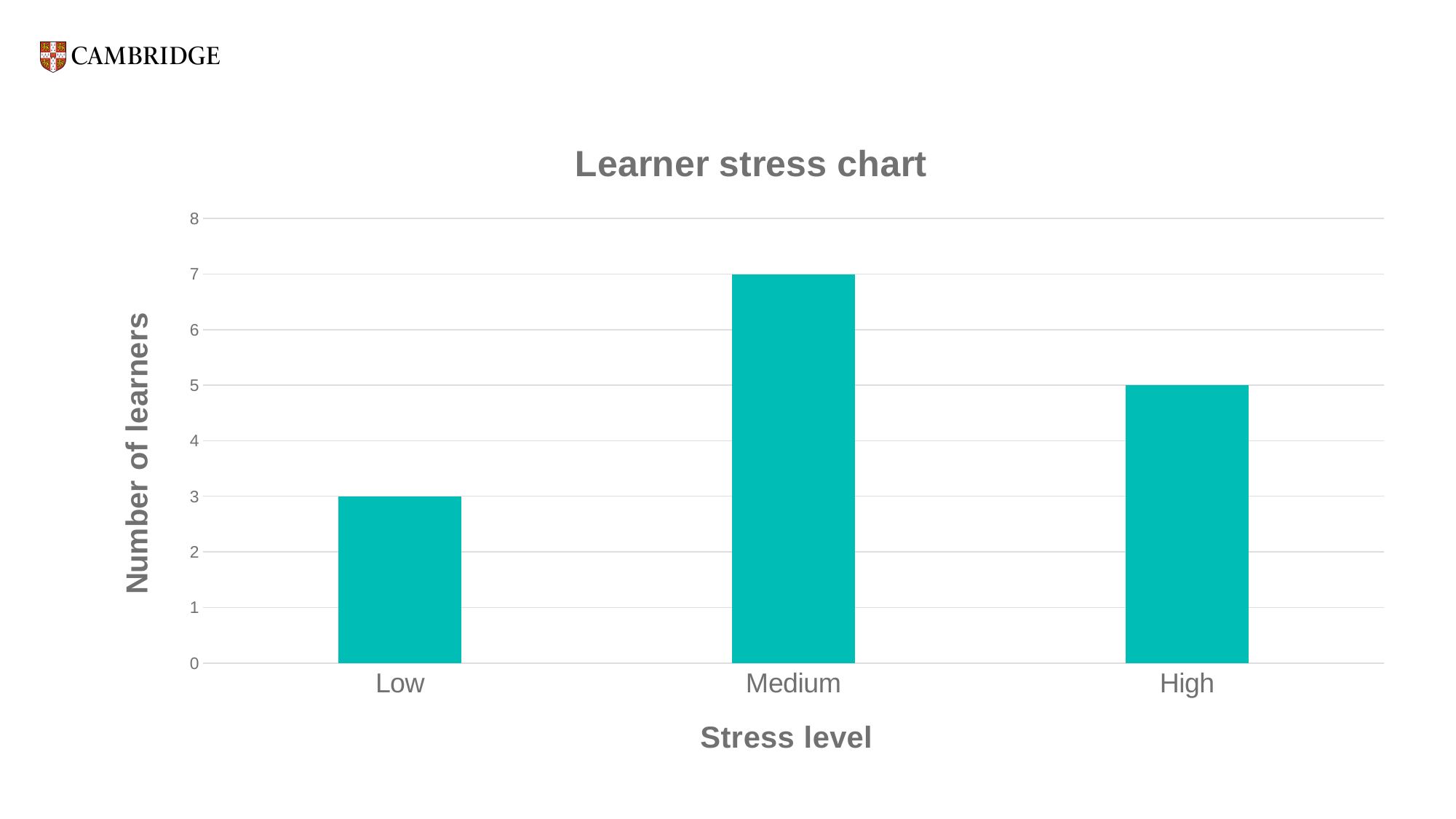
Which has more learners, the High or the Low stress level? High Which stress level has the lowest number of learners? Low What is the number of learners for the Medium stress level? 7 Which stress level has the highest number of learners? Medium How many stress level categories are shown on the chart? 3 What kind of chart is shown on the slide? Bar chart What is the title of the chart? Learner stress chart Is the number of learners for the Medium stress level greater or less than 6? greater What is the difference in number of learners between the Medium and Low stress levels? 4 What is the number of learners for the Low stress level? 3 What is the number of learners for the High stress level? 5 What is the difference in number of learners between the Medium and High stress levels? 2